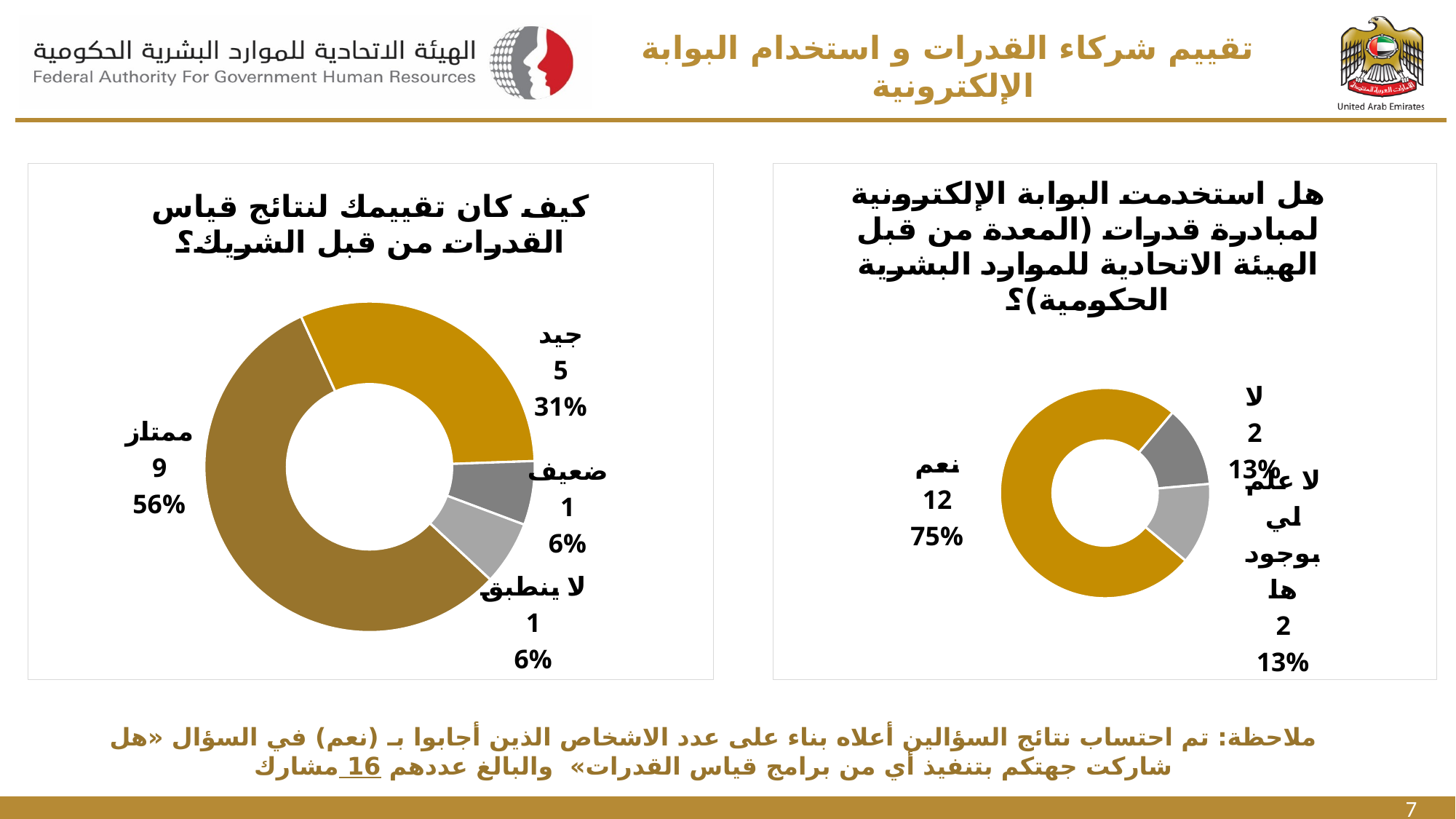
In the right chart, how many respondents answered نعم (yes)? 12 In the right chart, which category has the largest share? نعم In the left chart, which category has the largest share? ممتاز In the left chart, what percentage share does جيد (good) have? 31% In the left chart, what is the difference in count between ممتاز and جيد? 4 In the left chart, what percentage is shown for ضعيف (weak)? 6% In the left chart, how many categories are shown? 4 In the right chart, which is larger: the count for نعم or the count for لا? نعم In the right chart, how many categories are shown? 3 In the right chart, what percentage share does نعم (yes) have? 75% What type of chart is used on the left side of the slide? Doughnut chart In the left chart, how many respondents answered ممتاز (excellent)? 9